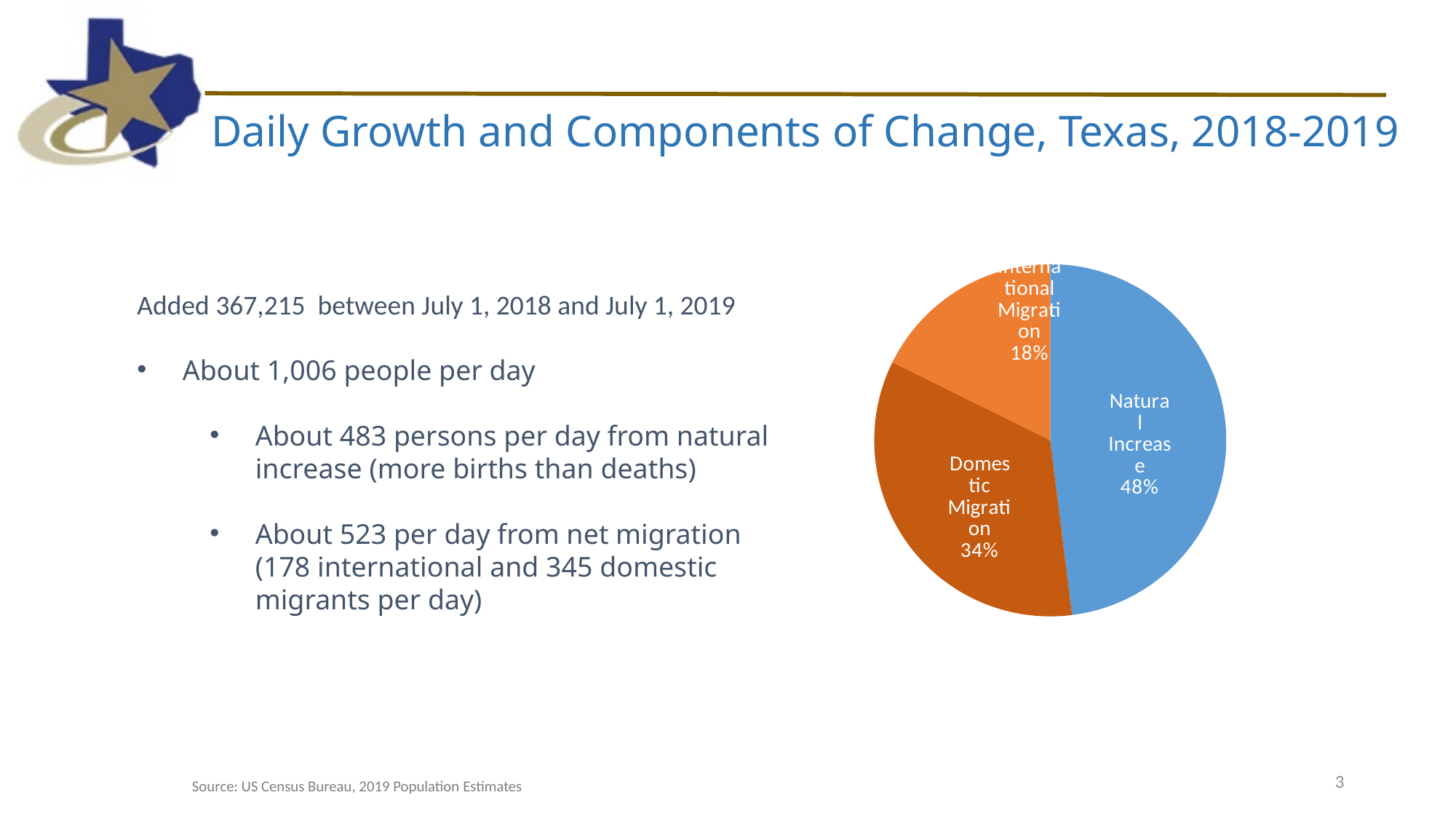
What colour is the Natural Increase slice of the pie chart? blue What share of the pie does Domestic Migration represent? 34% What share of the pie does International Migration represent? 18% How many slices does the pie chart have? 3 What kind of chart is shown on the slide? pie chart Which is larger, the Domestic Migration slice or the International Migration slice? Domestic Migration Which slice of the pie chart is the largest? Natural Increase What is the difference in percentage points between the Domestic Migration and International Migration slices? 16 Which slice of the pie chart is the smallest? International Migration What share of the pie does Natural Increase represent? 48% What is the difference in percentage points between the Natural Increase and Domestic Migration slices? 14 Is the share for Natural Increase greater or less than 50%? less